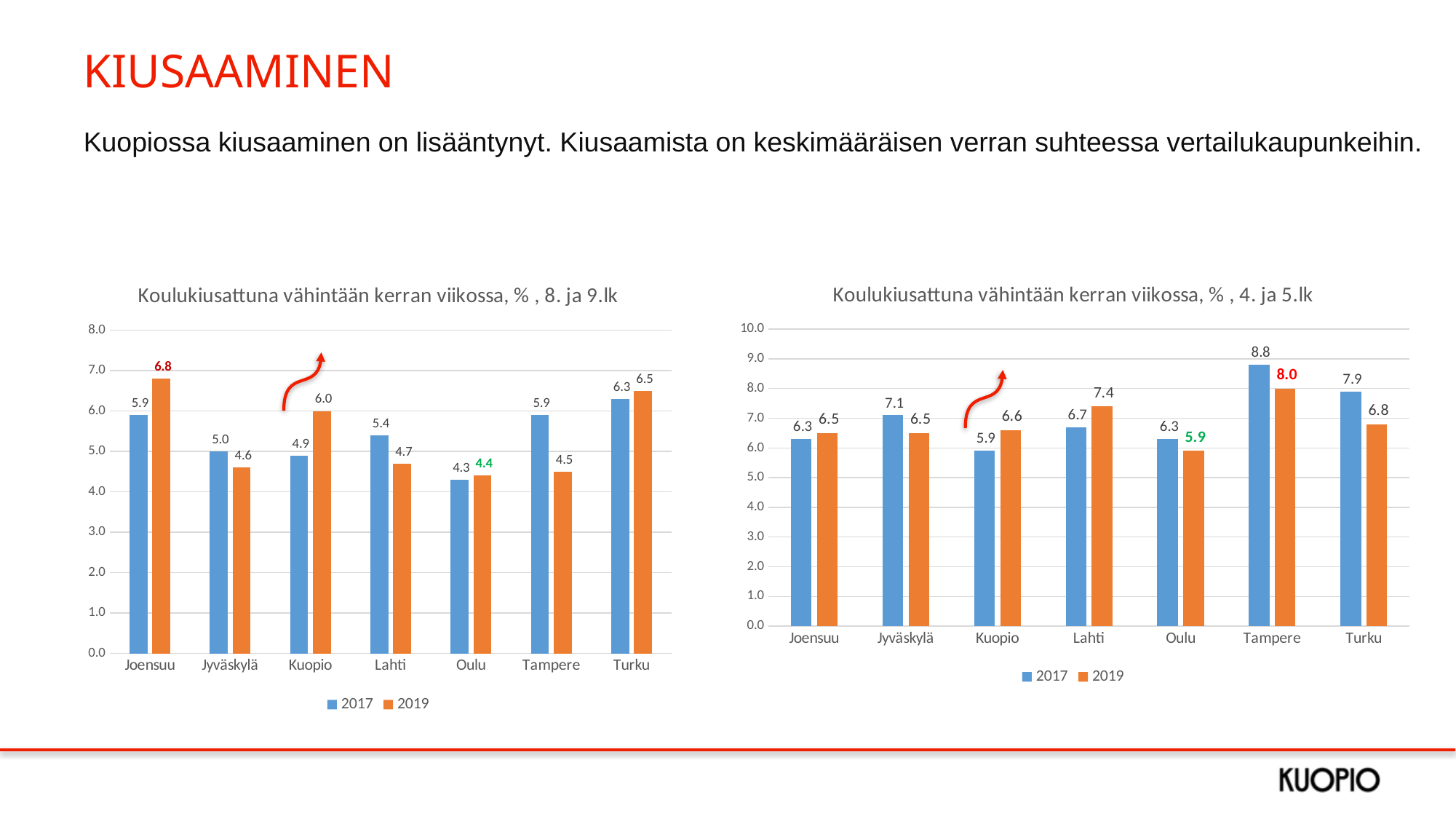
In the right chart (4. ja 5.lk), is the 2019 value for Turku larger or smaller than the 2017 value for Turku? smaller In the right chart (4. ja 5.lk), what is the 2019 value for Lahti? 7.4 In the right chart (4. ja 5.lk), which city has the lowest 2019 value? Oulu In the left chart (8. ja 9.lk), what is the difference between the 2019 and 2017 values for Kuopio? 1.1 In the left chart (8. ja 9.lk), what is the 2019 value for Kuopio? 6.0 In the right chart (4. ja 5.lk), what is the 2017 value for Tampere? 8.8 In the right chart (4. ja 5.lk), how many series does the legend list? 2 In the left chart (8. ja 9.lk), what is the 2017 value for Tampere? 5.9 What type of chart is the right chart (4. ja 5.lk)? bar chart In the left chart (8. ja 9.lk), which city has the lowest 2017 value? Oulu In the left chart (8. ja 9.lk), which city has the highest 2019 value? Joensuu In the left chart (8. ja 9.lk), how many cities are shown on the x axis? 7